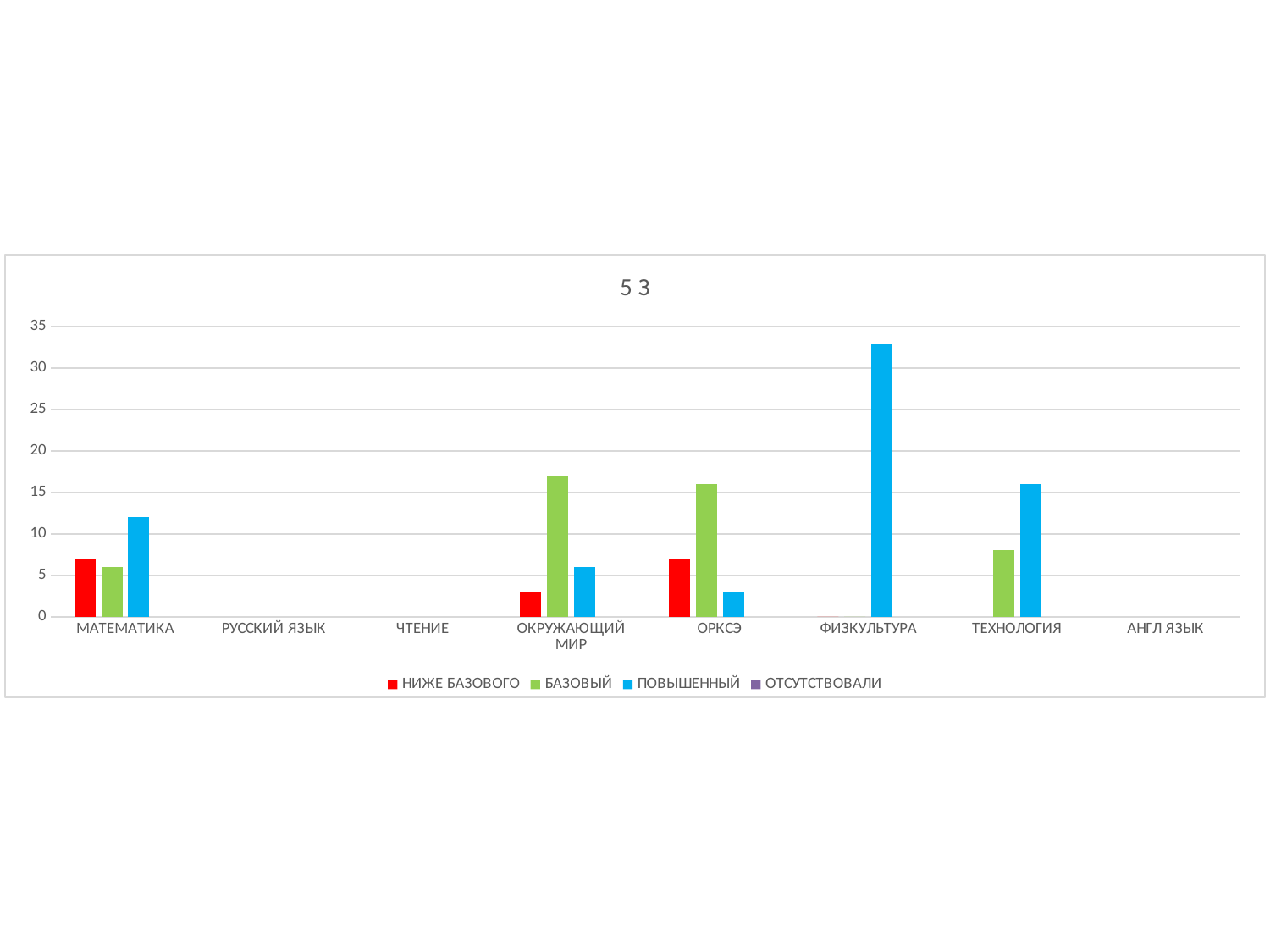
Is the БАЗОВЫЙ value for ОКРУЖАЮЩИЙ МИР greater or less than 15? greater How many categories are shown on the x axis? 8 How many series does the legend list? 4 Which category has the highest ПОВЫШЕННЫЙ bar? ФИЗКУЛЬТУРА For ТЕХНОЛОГИЯ, which is larger: the БАЗОВЫЙ bar or the ПОВЫШЕННЫЙ bar? ПОВЫШЕННЫЙ Is the ПОВЫШЕННЫЙ value for МАТЕМАТИКА greater or less than 10? greater What is the title of the chart? 5 3 Is the БАЗОВЫЙ value for ТЕХНОЛОГИЯ greater or less than 10? less For ОКРУЖАЮЩИЙ МИР, which is larger: the БАЗОВЫЙ bar or the ПОВЫШЕННЫЙ bar? БАЗОВЫЙ What kind of chart is shown on the slide? bar chart